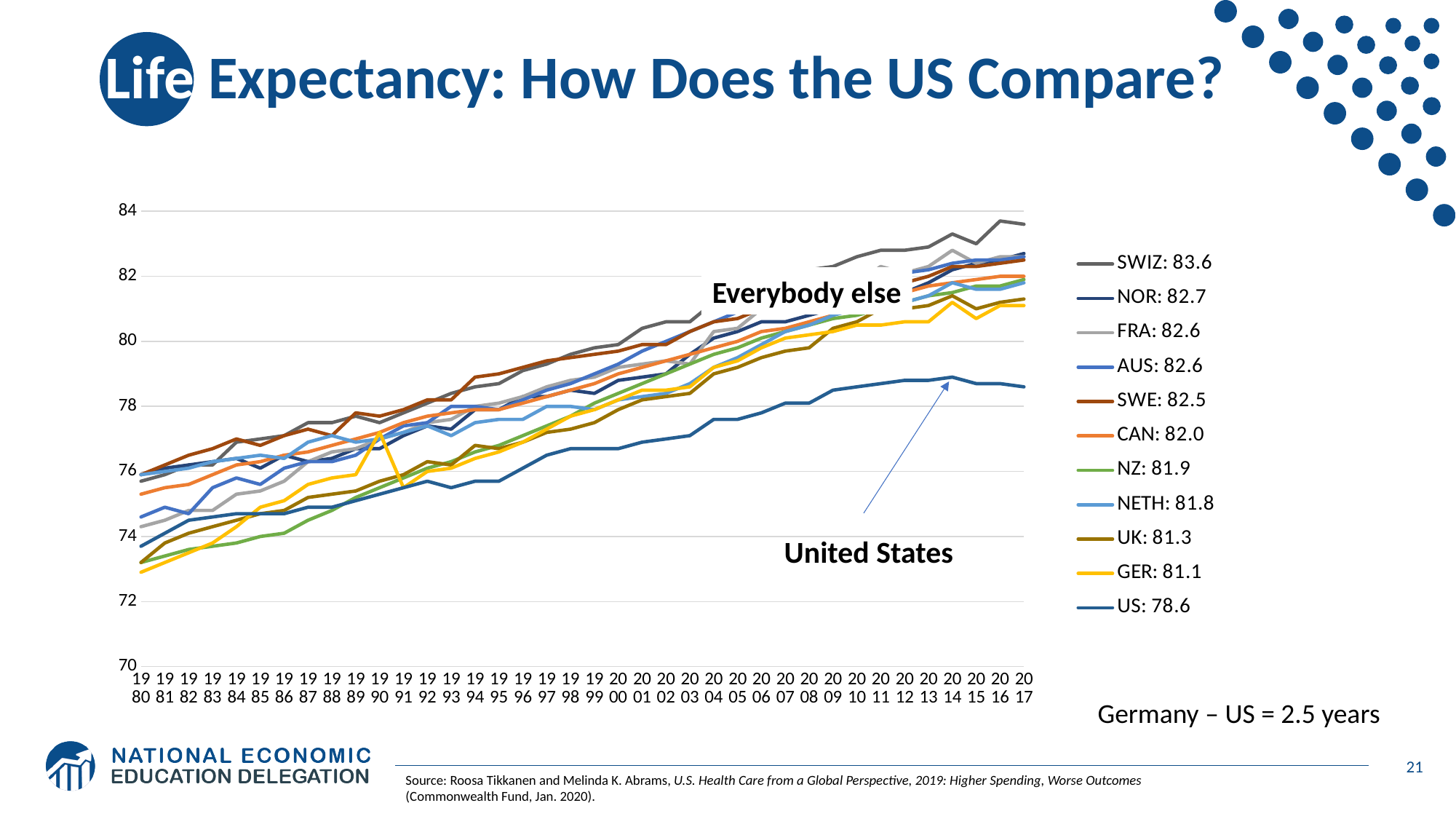
Which country has the highest value in the legend? SWIZ What kind of chart is shown on the slide? line chart What value is shown in the legend for SWIZ? 83.6 Is the value for US in 1980 greater or less than 74? less What value is shown in the legend for GER? 81.1 Does the US line generally rise or fall from 1980 to 2017? rise According to the text on the slide, what is the gap between Germany and the US? 2.5 years What is the difference between the legend values for SWIZ and US? 5.0 Which country has the lowest value in the legend? US What value is shown in the legend for US? 78.6 How many series does the legend list? 11 Which has a higher legend value, CAN or UK? CAN